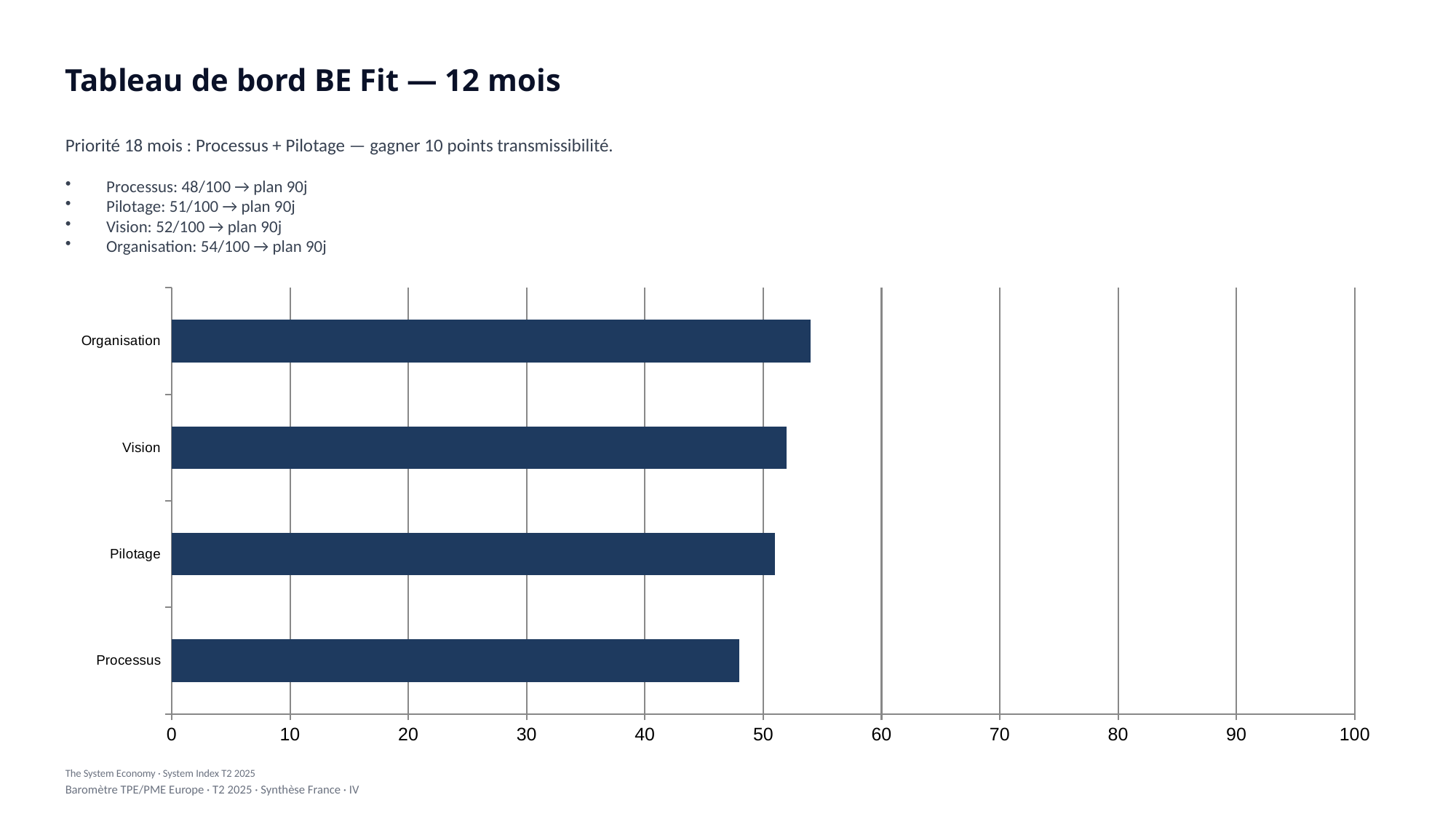
How many categories does the chart show? 4 What is the difference between the values for Organisation and Processus? 6 Is the value for Organisation greater or less than 50? greater Which category has the highest value? Organisation What is the value for Processus? 48 What is the title of the slide containing the chart? Tableau de bord BE Fit — 12 mois Is the value for Processus greater or less than 50? less What is the value for Organisation? 54 Which is larger, the value for Organisation or the value for Processus? Organisation What is the value for Pilotage? 51 Which category has the lowest value? Processus What kind of chart is shown on the slide? bar chart